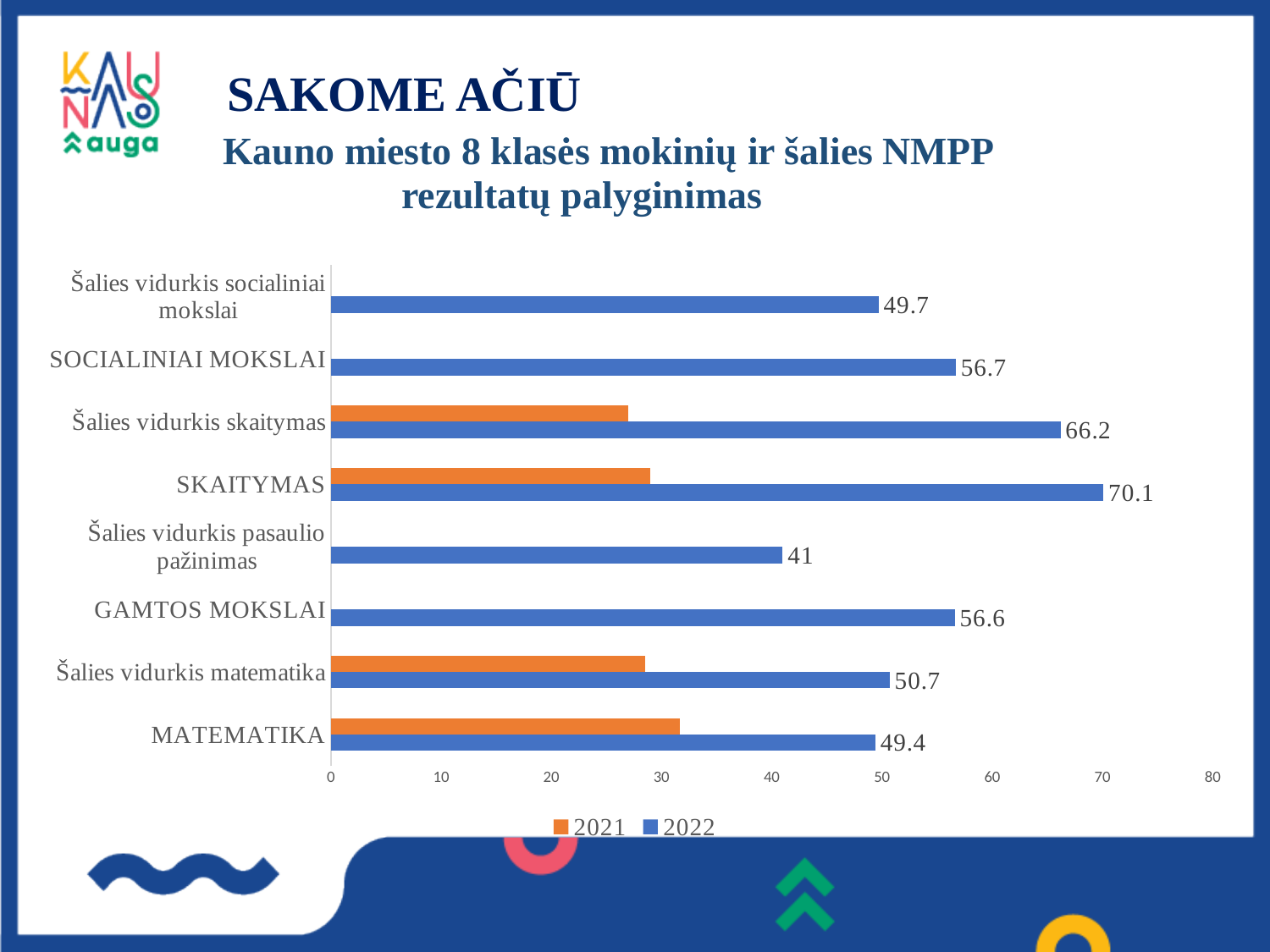
What is the 2022 value for Šalies vidurkis pasaulio pažinimas? 41 Which category has the highest 2022 value? SKAITYMAS What is the 2022 value for SKAITYMAS? 70.1 How many series does the legend list? 2 How many categories are shown on the chart? 8 Is the 2021 value for MATEMATIKA greater or less than 40? less Which is larger in 2022: SOCIALINIAI MOKSLAI or Šalies vidurkis socialiniai mokslai? SOCIALINIAI MOKSLAI What kind of chart is shown on the slide? bar chart What is the difference between the 2022 values for SKAITYMAS and Šalies vidurkis skaitymas? 3.9 Which colour represents the 2021 series in the legend? orange What is the 2022 value for MATEMATIKA? 49.4 Which category has the lowest 2022 value? Šalies vidurkis pasaulio pažinimas